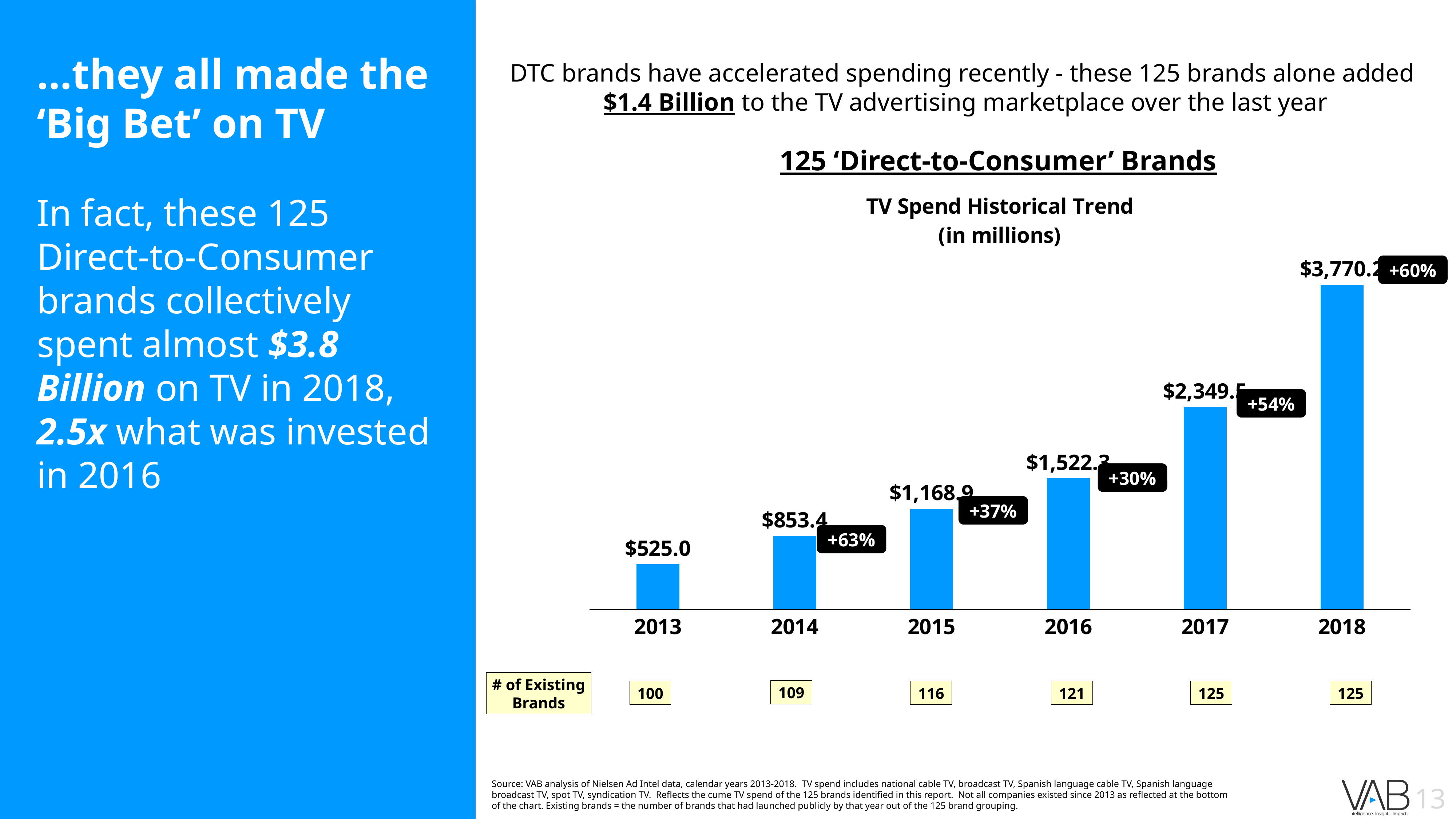
What was the TV spend for 2015 in the TV Spend Historical Trend chart? $1,168.9 What was the TV spend for 2013 in the TV Spend Historical Trend chart? $525.0 Which year has the highest TV spend in the chart? 2018 What was the TV spend for 2014 in the TV Spend Historical Trend chart? $853.4 Which year has the lowest TV spend in the chart? 2013 Which year had higher TV spend, 2015 or 2016? 2016 What year-over-year growth percentage is labelled on the 2014 bar? +63% Do the TV spend values rise or fall from 2013 to 2018? Rise What is the difference in TV spend between 2014 and 2013? $328.4 How many existing brands are listed below the chart for 2016? 121 How many years are shown in the TV Spend Historical Trend chart? 6 What type of chart is the TV Spend Historical Trend chart? Bar chart